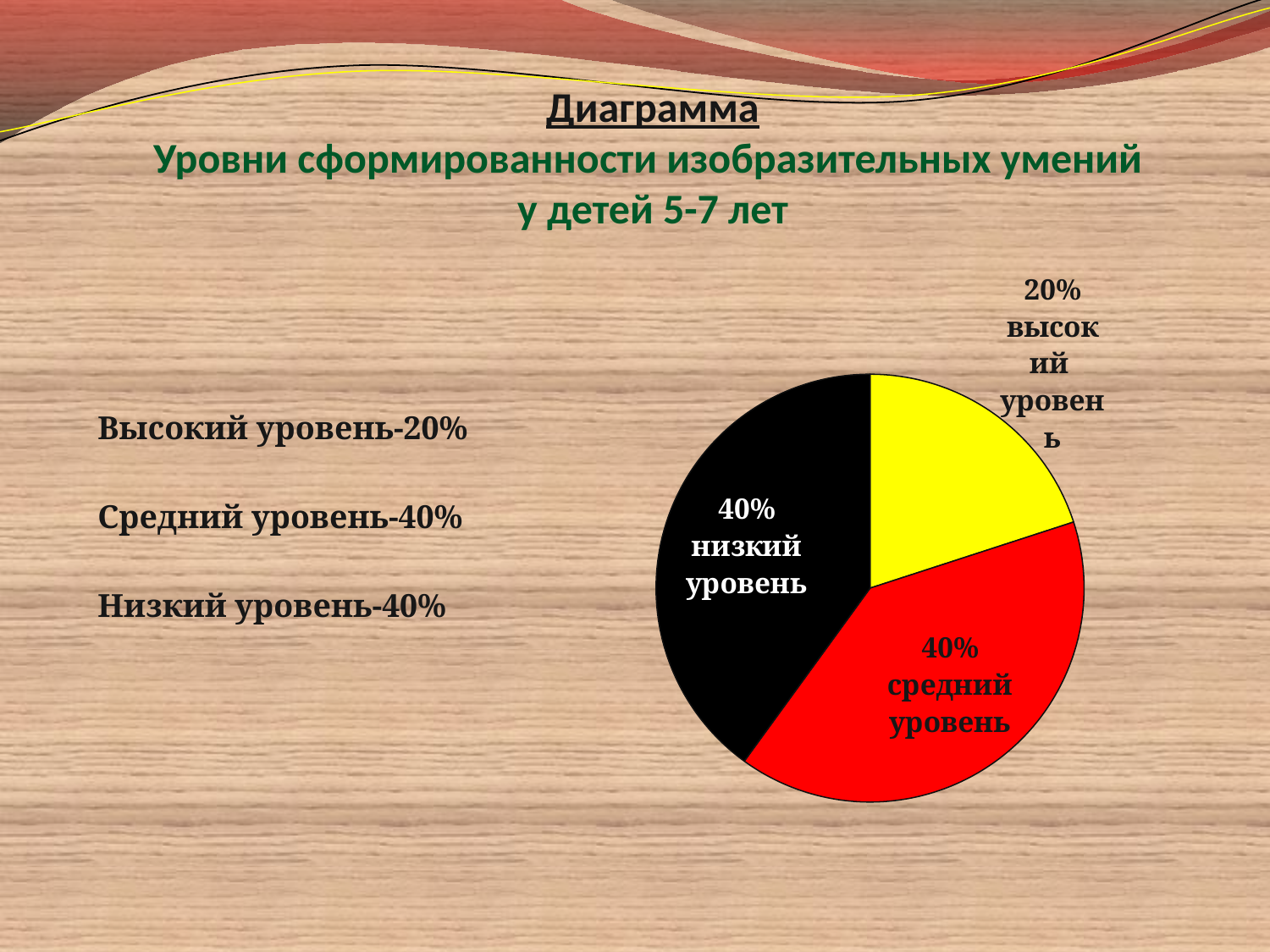
What share of the pie is labelled "средний уровень"? 40% How many slices does the pie chart have? 3 What share of the pie is labelled "низкий уровень"? 40% Which is larger, the slice for "низкий уровень" or the slice for "высокий уровень"? низкий уровень Which slice of the pie is the smallest? высокий уровень What kind of chart is shown on the slide? pie chart What is the difference between the share for "средний уровень" and the share for "высокий уровень"? 20% What colour is the slice for "высокий уровень"? yellow What is the combined share of "средний уровень" and "низкий уровень"? 80% What colour is the slice for "средний уровень"? red What share of the pie is labelled "высокий уровень"? 20%